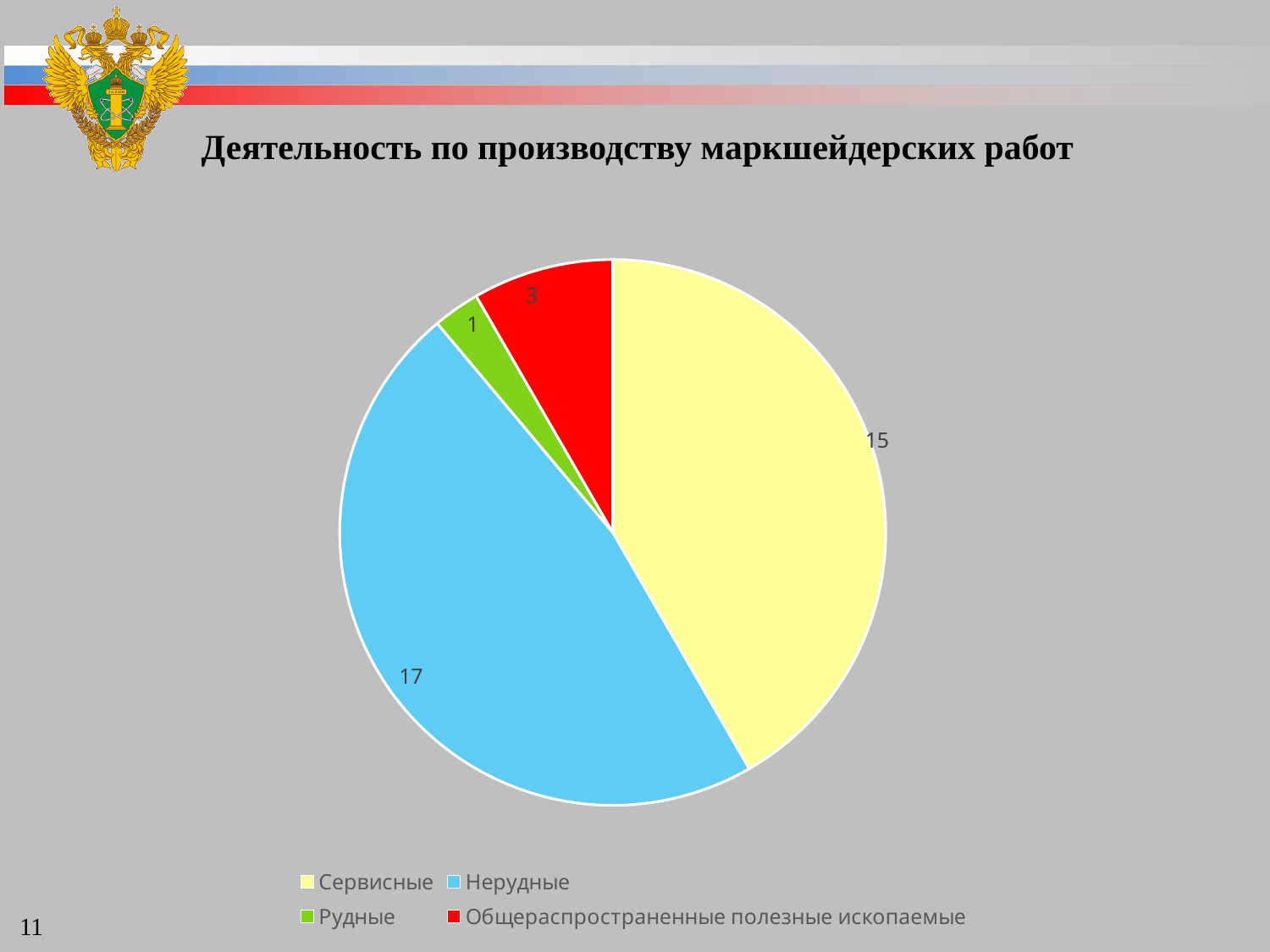
Which category has the smallest slice of the pie? Рудные What is the total of all slices in the pie chart? 36 What is the title of the chart on the slide? Деятельность по производству маркшейдерских работ Which category has the largest slice of the pie? Нерудные What is the value for Сервисные? 15 What is the value for Общераспространенные полезные ископаемые? 3 What kind of chart is shown on the slide? pie chart How many categories does the pie chart have? 4 What is the value for Рудные? 1 What is the value for Нерудные? 17 Which is larger, the value for Общераспространенные полезные ископаемые or the value for Рудные? Общераспространенные полезные ископаемые What is the difference between the values for Нерудные and Сервисные? 2